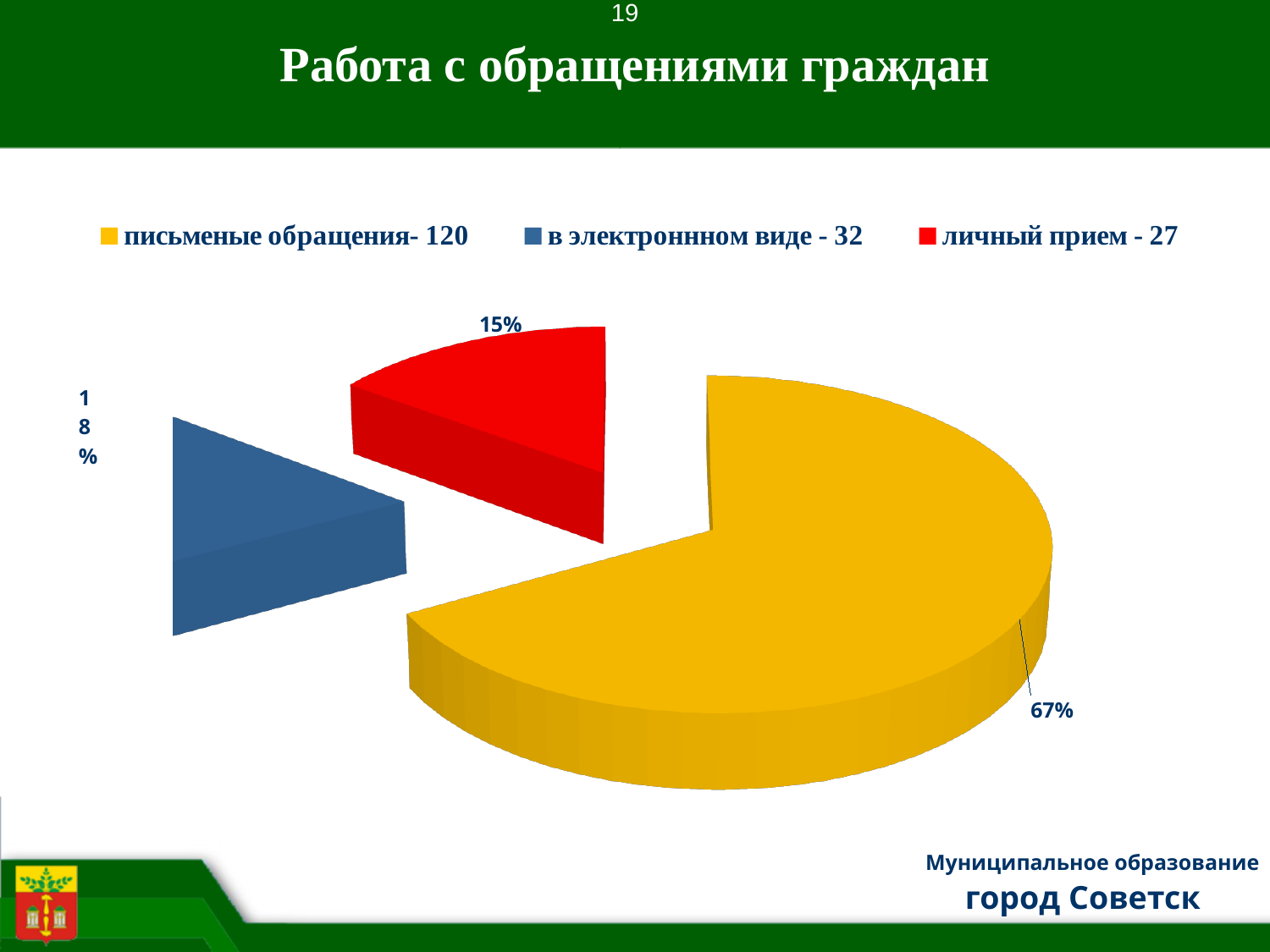
Which category has the smallest slice of the pie? личный прием What share of the pie does "личный прием" take? 15% Which slice is larger: "в электроннном виде" or "личный прием"? в электроннном виде Which category has the largest slice of the pie? письменые обращения What is the title of the slide containing the pie chart? Работа с обращениями граждан By how many percentage points does the share of "письменые обращения" exceed the share of "личный прием"? 52 What share of the pie does "письменые обращения" take? 67% What kind of chart is shown on the slide? pie chart How many slices does the pie chart have? 3 What share of the pie does "в электроннном виде" take? 18% What colour is the slice for "личный прием"? red According to the legend, how many appeals were "в электроннном виде"? 32